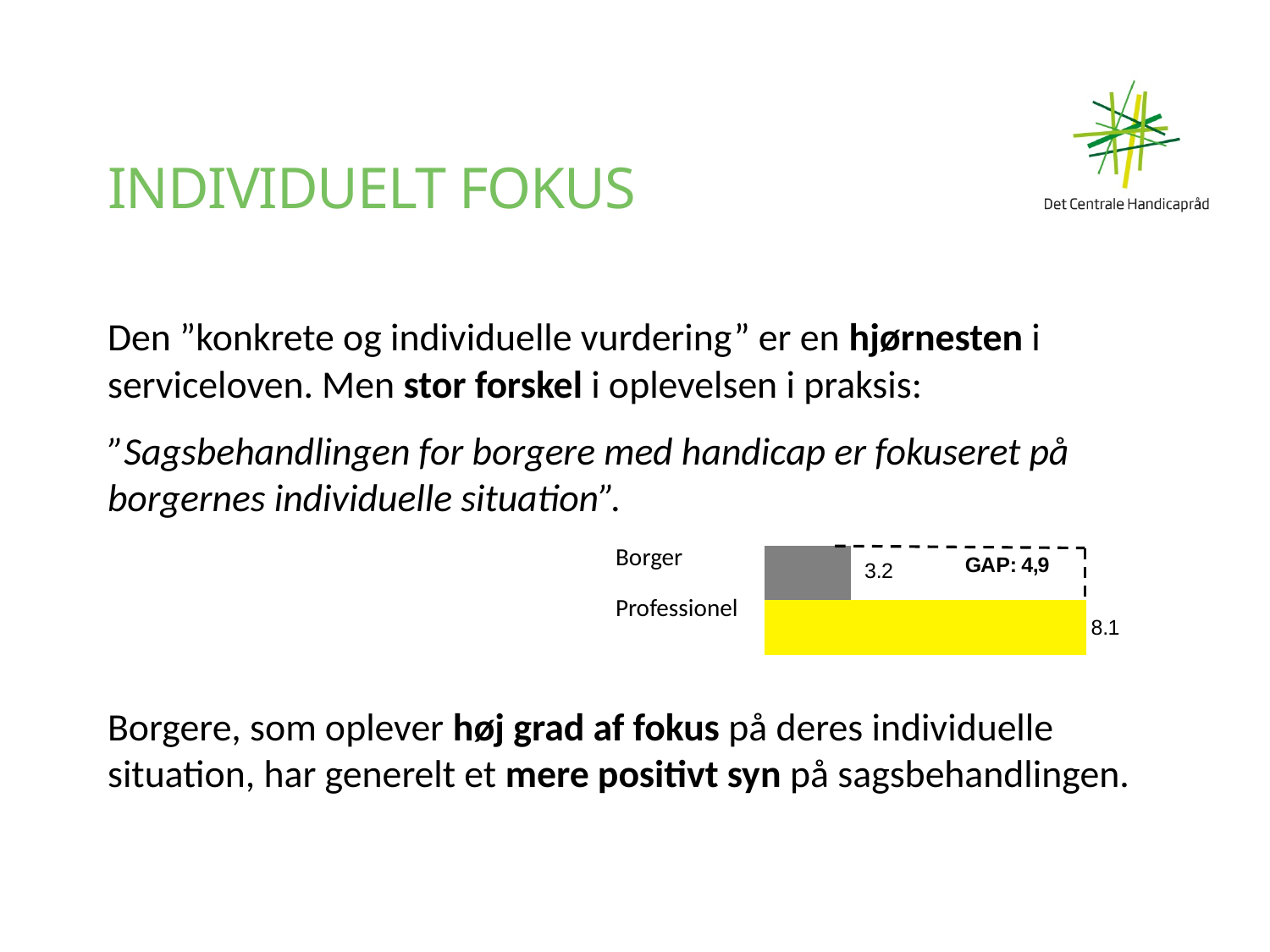
What is the value for Borger in the bar chart? 3.2 Which is larger in the bar chart, the value for Borger or the value for Professionel? Professionel What is the value for Professionel in the bar chart? 8.1 What kind of chart is shown on the slide? Bar chart What is the difference between the values for Professionel and Borger in the bar chart? 4.9 What colour is the bar for Professionel in the bar chart? Yellow Which category has the highest value in the bar chart? Professionel Which category has the lowest value in the bar chart? Borger How many categories are shown in the bar chart? 2 What gap value is annotated on the bar chart? GAP: 4,9